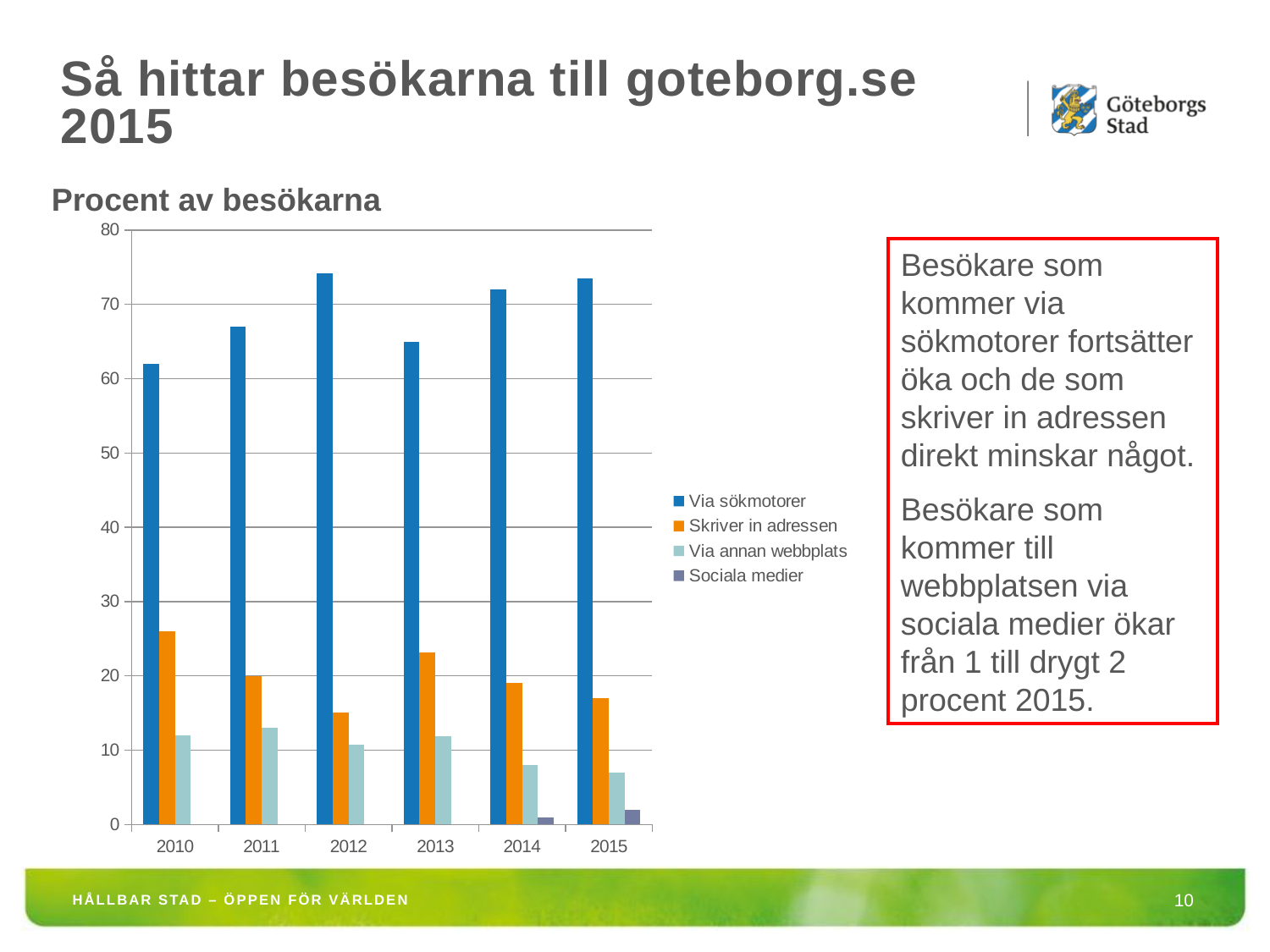
What kind of chart is shown on the slide? bar chart Is the value for Via sökmotorer in 2010 greater or less than 60? greater Is the value for Via annan webbplats in 2014 greater or less than 10? less Is the value for Skriver in adressen in 2012 greater or less than 20? less Which is larger in 2015, Via sökmotorer or Skriver in adressen? Via sökmotorer In which year is the value for Skriver in adressen highest? 2010 In which year is the value for Via sökmotorer lowest? 2010 How many years are shown on the x axis of the chart? 6 How many series does the chart legend list? 4 Does the value for Sociala medier rise or fall from 2014 to 2015? rise